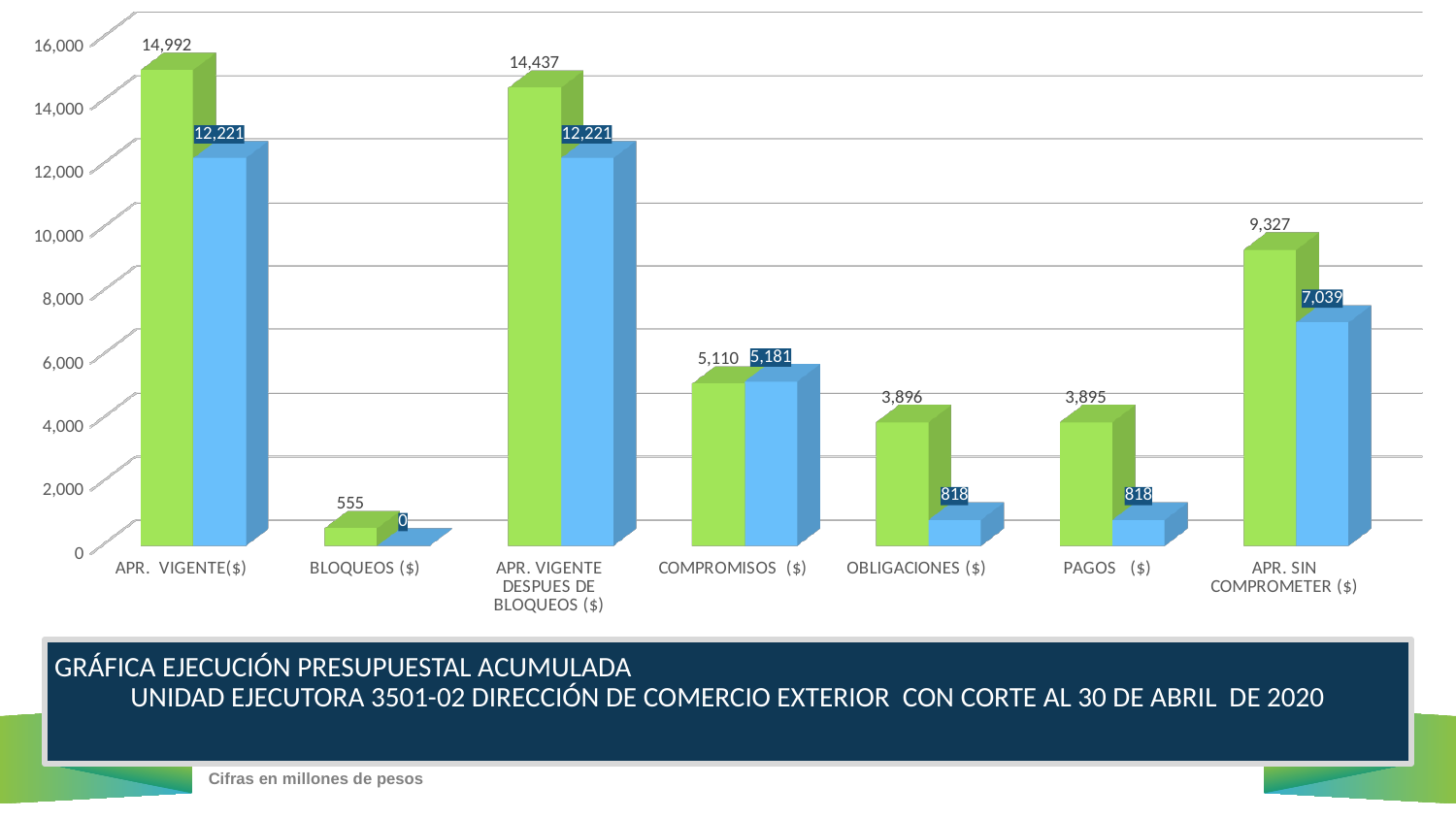
What is the value of the green bar for COMPROMISOS ($)? 5,110 Which category has the lowest green bar? BLOQUEOS ($) Is the green bar for APR. SIN COMPROMETER ($) greater or less than 8,000? greater How many categories are shown on the x axis? 7 What is the value of the blue bar for APR. SIN COMPROMETER ($)? 7,039 Which category has the highest green bar? APR. VIGENTE($) What is the difference between the green bars for APR. VIGENTE($) and APR. VIGENTE DESPUES DE BLOQUEOS ($)? 555 For COMPROMISOS ($), which is larger, the green bar or the blue bar? the blue bar What is the difference between the green bar and the blue bar for OBLIGACIONES ($)? 3,078 What is the value of the green bar for APR. VIGENTE($)? 14,992 What kind of chart is shown on the slide? bar chart What is the value of the blue bar for BLOQUEOS ($)? 0